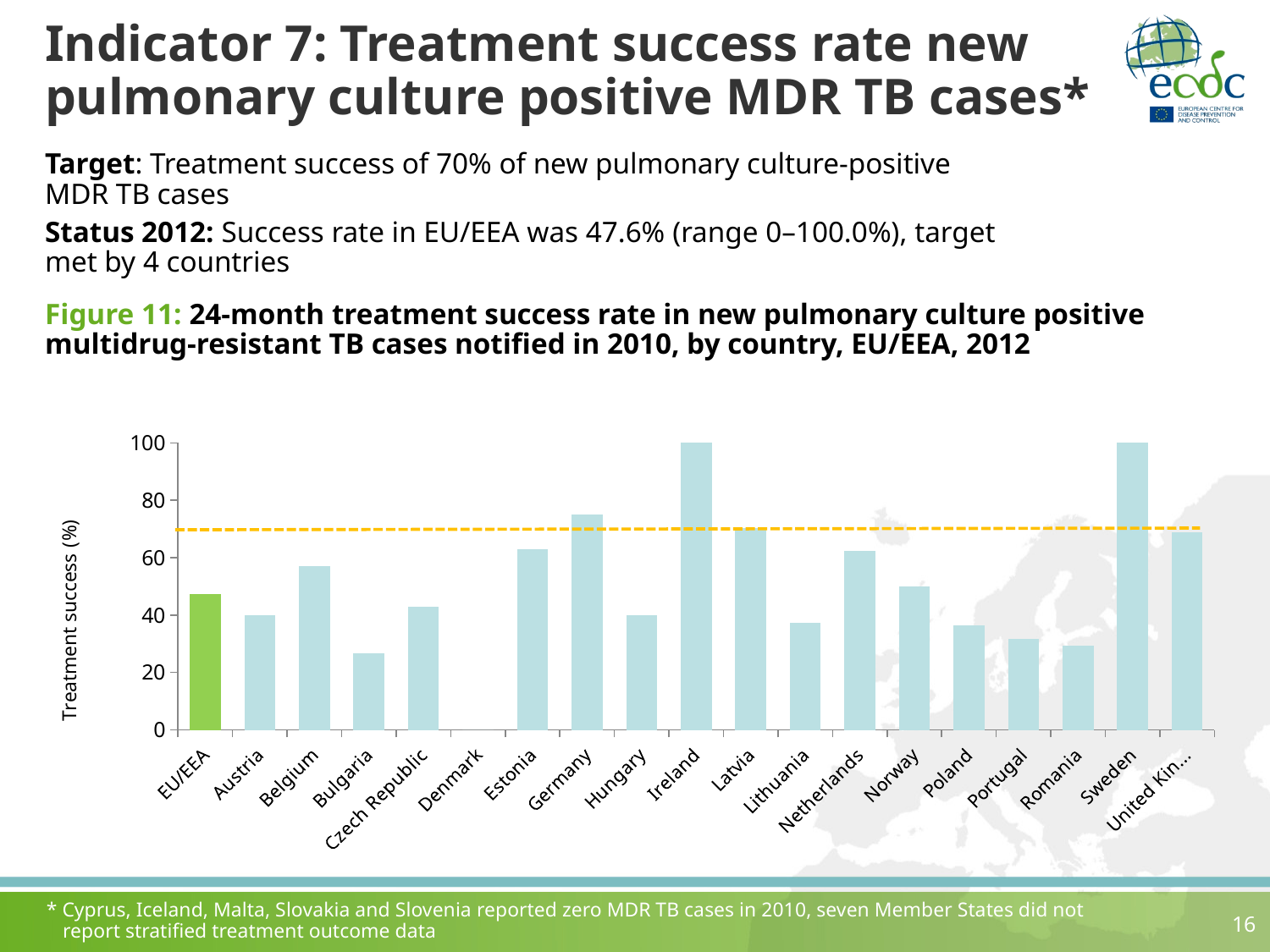
What kind of chart is shown in Figure 11? bar chart Is the value for Denmark greater or less than 20? less Is the value for Romania greater or less than 40? less Which has the higher treatment success value, Germany or Austria? Germany Is the value for Bulgaria greater or less than 40? less What is the treatment success value for Sweden in the chart? 100 What is the treatment success value for Ireland in the chart? 100 What is the label on the y axis of the chart? Treatment success (%) How many categories (bars) are shown along the x axis of the chart? 19 Which has the lower treatment success value, Belgium or Bulgaria? Bulgaria